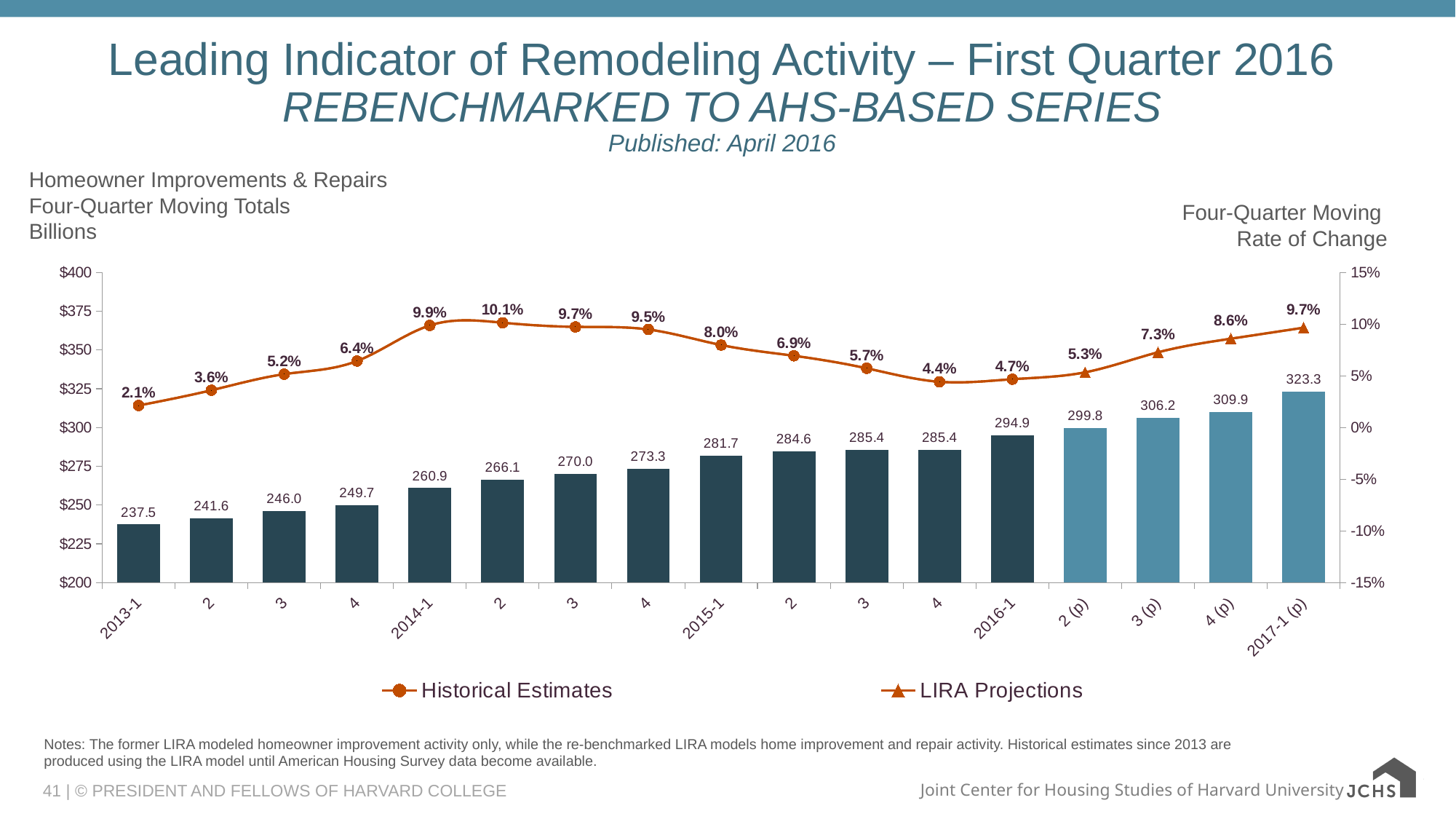
How many quarters are plotted on the x axis? 17 What is the four-quarter moving total (in billions) for 2016-1? 294.9 What is the four-quarter moving rate of change shown for 2014-2? 10.1% Which is larger, the rate of change for 2015-4 or for 2016-1? 2016-1 Which quarter has the lowest four-quarter moving total? 2013-1 Is the four-quarter moving total for 2015-1 greater or less than $275? greater What marker shape is used for the LIRA Projections series in the legend? triangle What is the difference between the four-quarter moving totals for 2017-1 (p) and 2016-1? 28.4 Which quarter has the highest four-quarter moving rate of change? 2014-2 Does the four-quarter moving total rise or fall from 2013-1 to 2017-1 (p)? rise How many series does the legend list? 2 What is the projected four-quarter moving total for 2017-1 (p)? 323.3